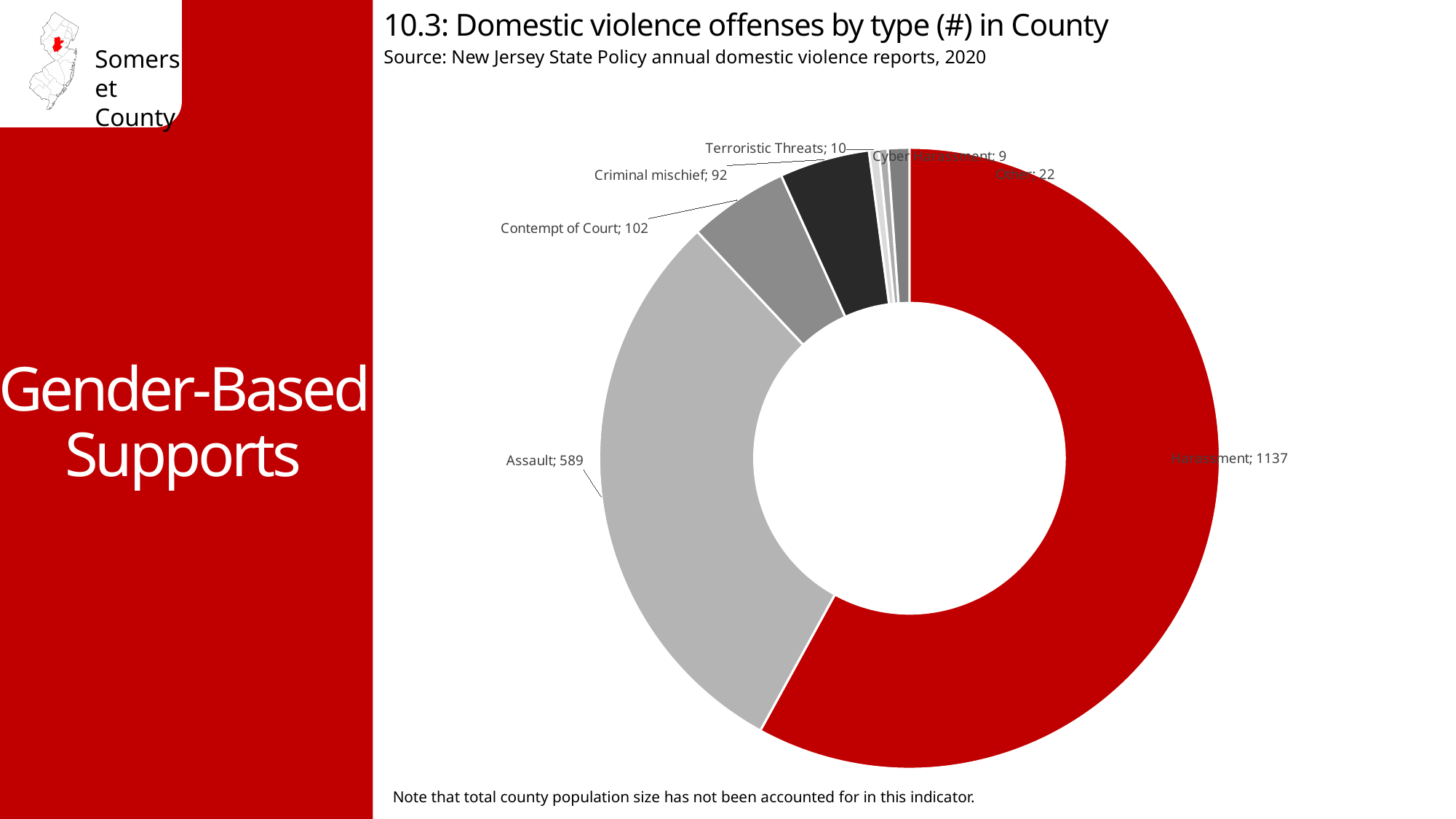
Which is larger, Contempt of Court or Criminal mischief? Contempt of Court What kind of chart is shown on the slide? doughnut chart What is the value for Other? 22 What is the number of Harassment offenses shown in the chart? 1137 What is the number of Assault offenses shown in the chart? 589 How many offense types (slices) are shown in the chart? 7 Which offense type has the smallest number of offenses? Cyber Harassment What is the source cited for the chart? New Jersey State Policy annual domestic violence reports, 2020 What is the value for Criminal mischief? 92 Which offense type has the largest number of offenses? Harassment What is the difference between the Harassment and Assault values? 548 What is the value for Contempt of Court? 102